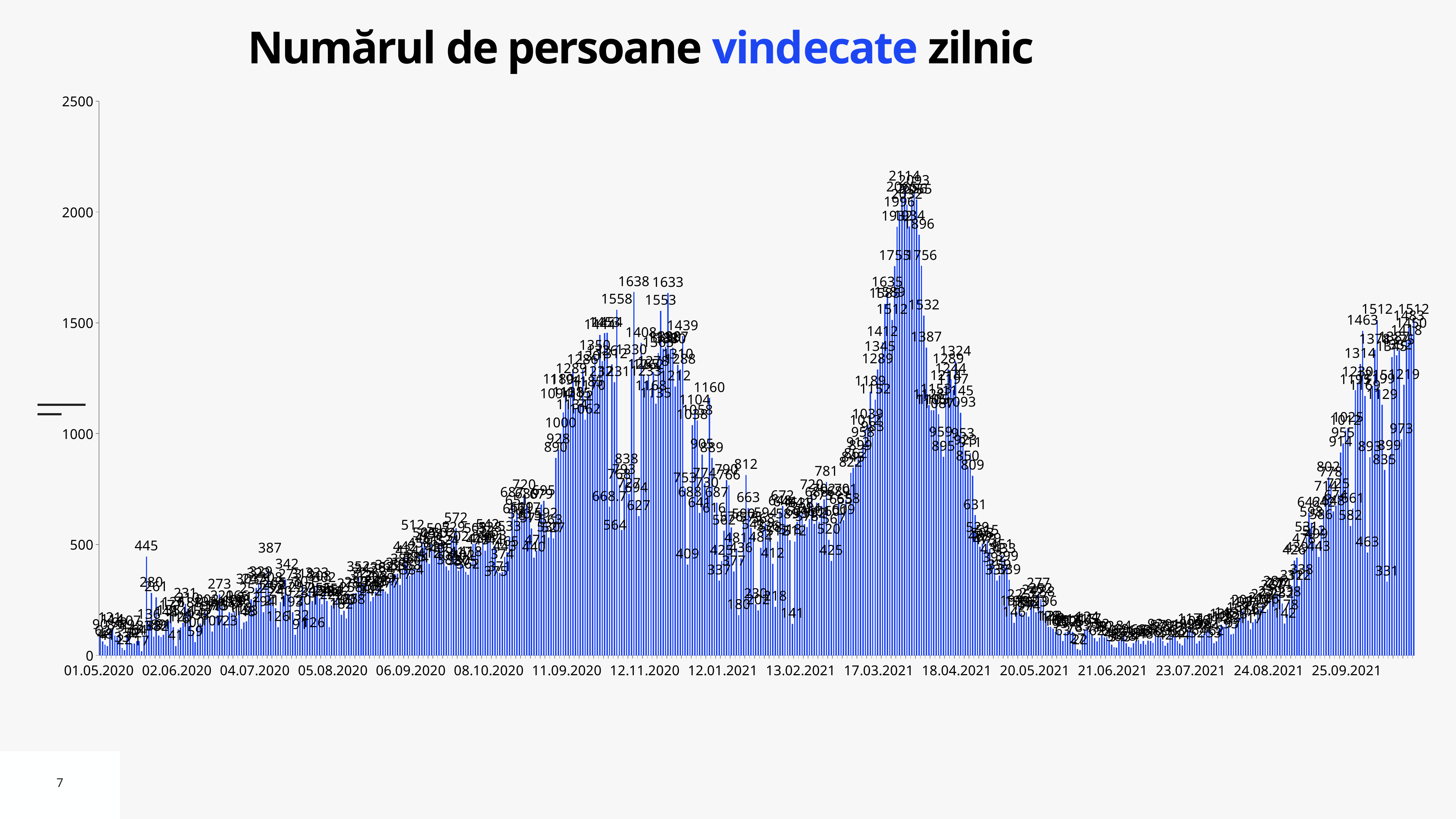
What is the highest value labeled on the chart? 2114 What kind of chart is shown on the slide? bar chart Is the highest bar on the chart greater or less than 2000? greater What is the title of the chart? Numărul de persoane vindecate zilnic What is the maximum value shown on the y axis? 2500 How many date labels are shown on the x axis? 17 What is the value of the isolated spike shortly before 02.06.2020? 445 Are the values around 21.06.2021 greater or less than 500? less Which peak is higher: the one near 12.11.2020 or the one between 17.03.2021 and 18.04.2021? the one between 17.03.2021 and 18.04.2021 What is the value of the spike just after 04.07.2020? 387 Do the values rise or fall between 24.08.2021 and 25.09.2021? rise What is the difference between the overall peak value (2114) and the highest value of the November 2020 peak (1638)? 476